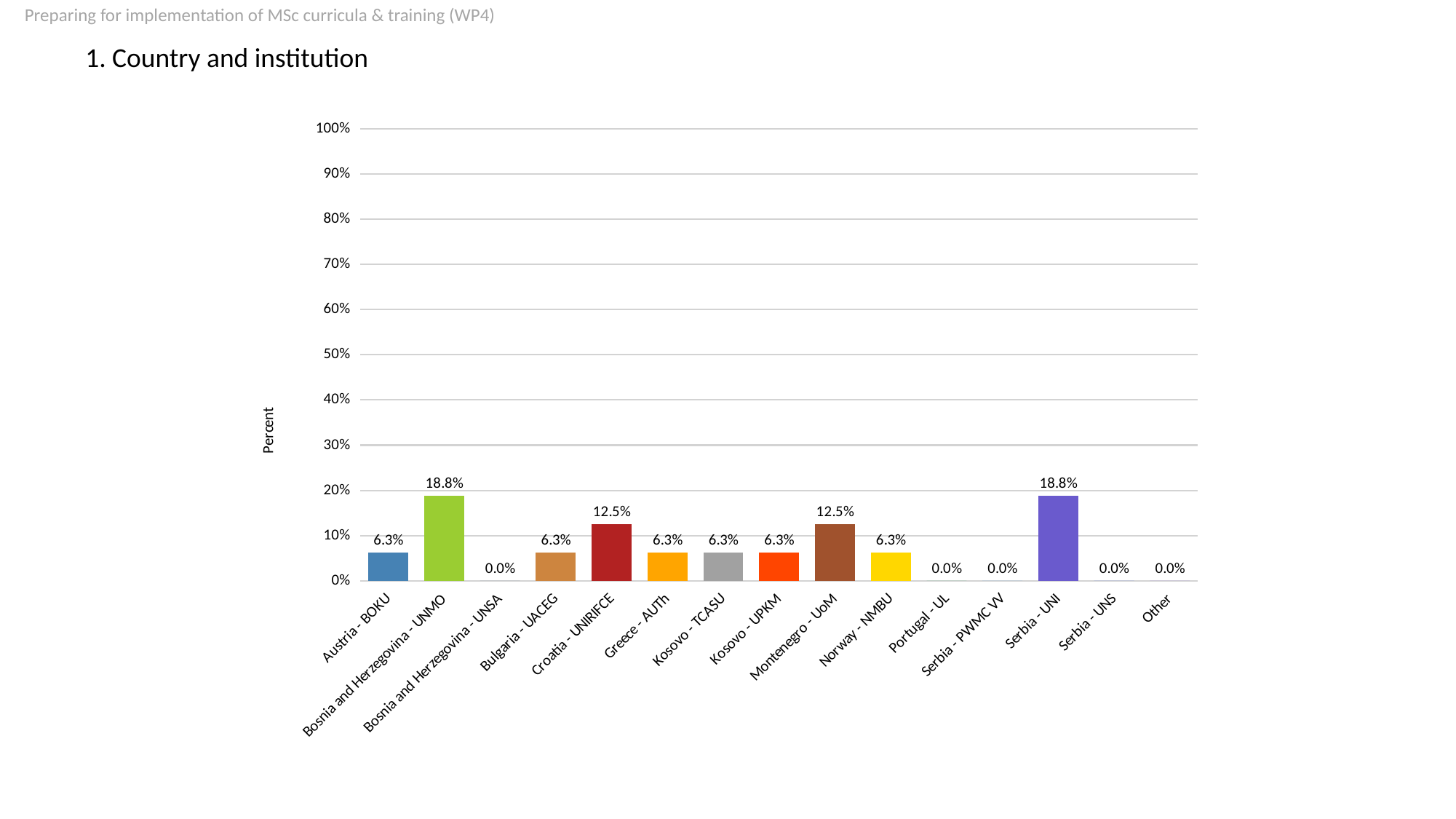
What is the value for Croatia - UNIRIFCE? 12.5% What is the value for Austria - BOKU? 6.3% What is the value for Bosnia and Herzegovina - UNMO? 18.8% What is the difference between the values for Croatia - UNIRIFCE and Greece - AUTh? 6.2% What kind of chart is shown on the slide? bar chart What is the label of the y axis? Percent What is the value for Montenegro - UoM? 12.5% Is the value for Bosnia and Herzegovina - UNMO greater or less than 10%? greater Which is larger, the value for Montenegro - UoM or the value for Kosovo - UPKM? Montenegro - UoM How many categories are shown on the x axis? 15 What is the value for Serbia - UNS? 0.0% What is the difference between the values for Serbia - UNI and Norway - NMBU? 12.5%